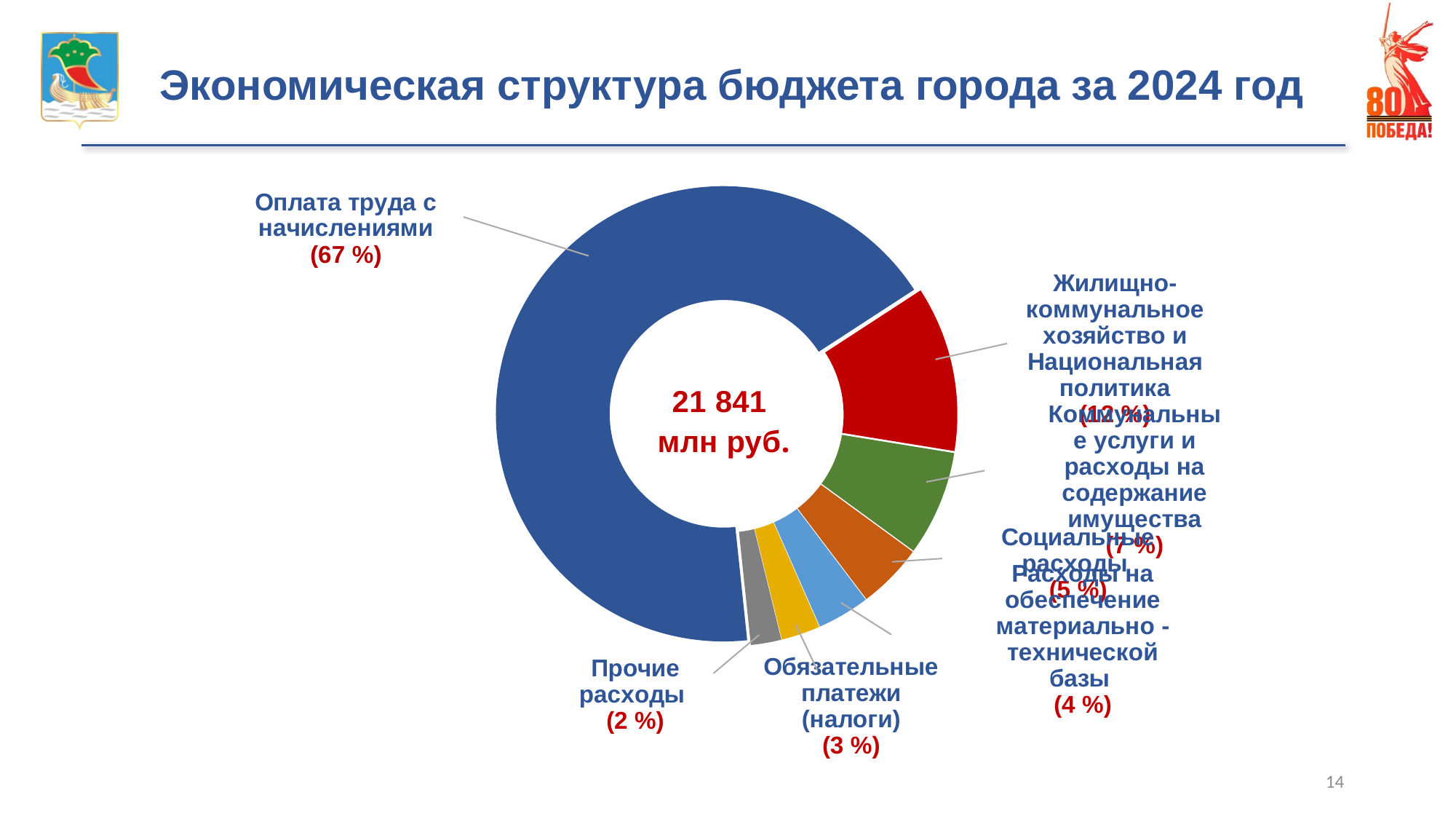
What share of the budget is "Социальные расходы"? 5 % Which category has the smallest share of the budget? Прочие расходы What share of the budget is "Коммунальные услуги и расходы на содержание имущества"? 7 % What share of the budget is "Обязательные платежи (налоги)"? 3 % By how many percentage points does "Оплата труда с начислениями" exceed "Прочие расходы"? 65 % What share of the budget is "Прочие расходы"? 2 % What share of the budget is "Оплата труда с начислениями"? 67 % How many categories (slices) does the chart show? 7 What total amount is shown in the centre of the chart? 21 841 млн руб. Which is larger: "Социальные расходы" or "Расходы на обеспечение материально-технической базы"? Социальные расходы Which category has the largest share of the budget? Оплата труда с начислениями What kind of chart is shown on the slide? doughnut chart